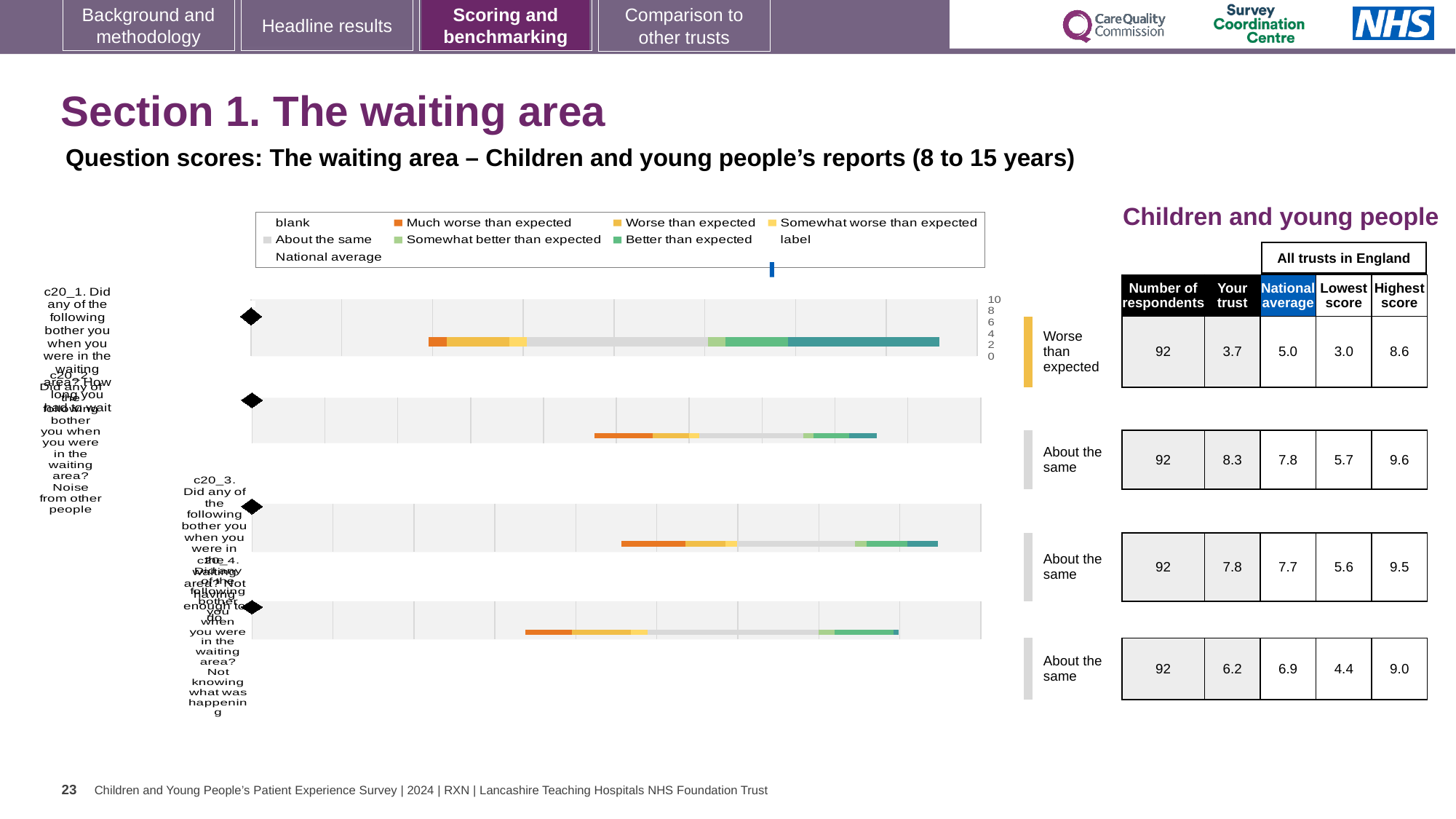
In the table beside the chart, what is the 'Your trust' score for the top (first) question row? 3.7 Which question row has the lowest 'Your trust' score in the table? the first row (3.7) How many respondents are listed for each question row in the table? 92 How many question rows (bars) are plotted in the chart? 4 How many entries does the chart legend list? 9 In the table beside the chart, what is the highest score across all trusts in England for the fourth (bottom) question row? 9.0 In the table beside the chart, what is the national average for the second question row? 7.8 What benchmark category label is shown for the top (first) question row? Worse than expected What is the difference between the highest and lowest 'Your trust' scores in the table? 4.6 What is the maximum value shown on the chart's score axis? 10 Which question row has the highest 'Your trust' score in the table? the second row (8.3) What type of chart is used to show the question scores on this slide? bar chart